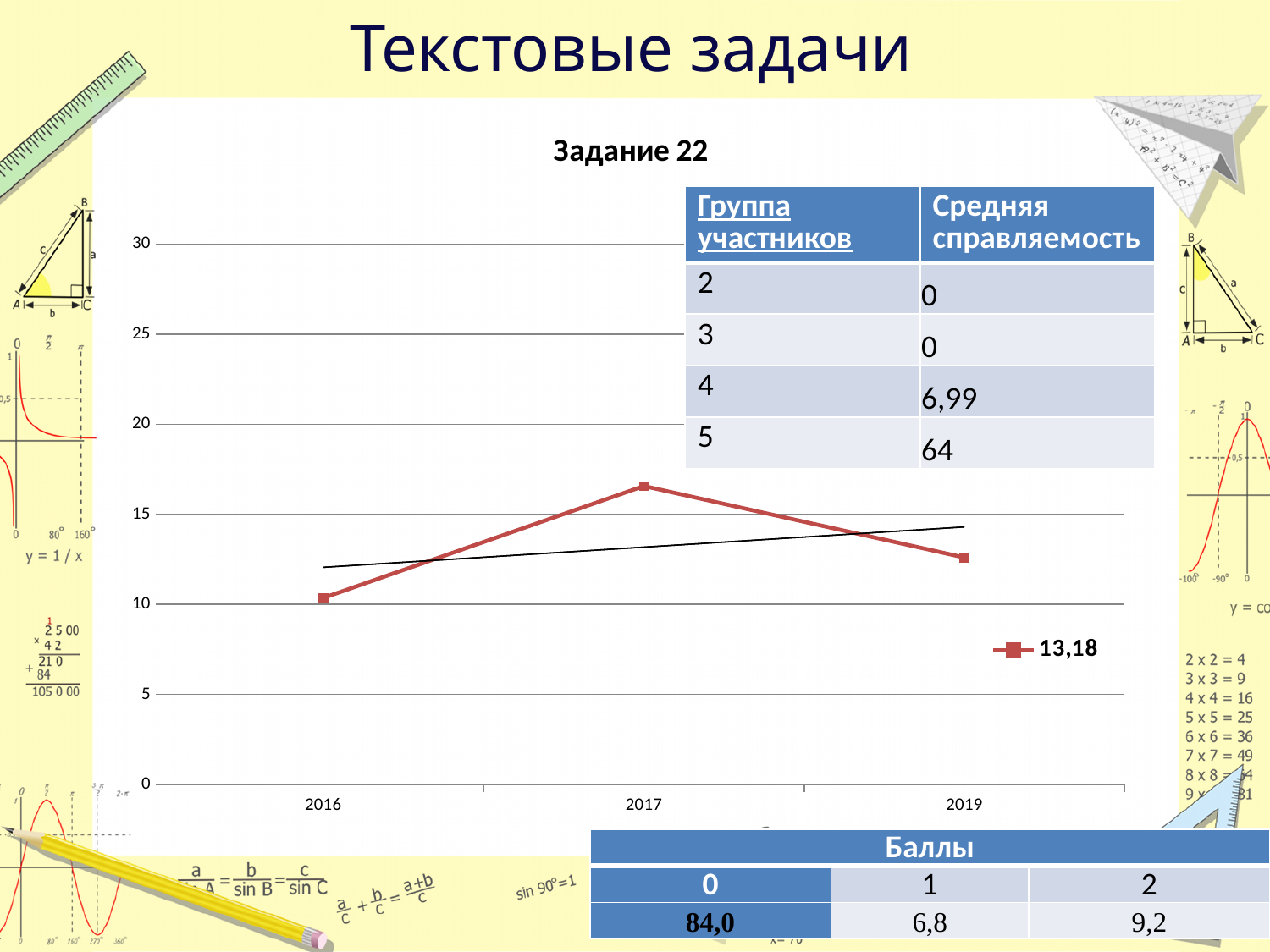
What kind of chart is shown on the slide? line chart How many data points are plotted on the red line? 3 Is the value for 2017 greater or less than 15? greater Does the red line rise or fall from 2017 to 2019? fall What is the legend entry for the red line? 13,18 Which year has the lowest value on the red line? 2016 What is the title of the chart? Задание 22 Which year has the highest value on the red line? 2017 Which is larger, the value for 2017 or the value for 2019? 2017 Is the value for 2017 greater or less than 20? less How many series does the chart legend list? 1 Is the value for 2019 greater or less than 15? less